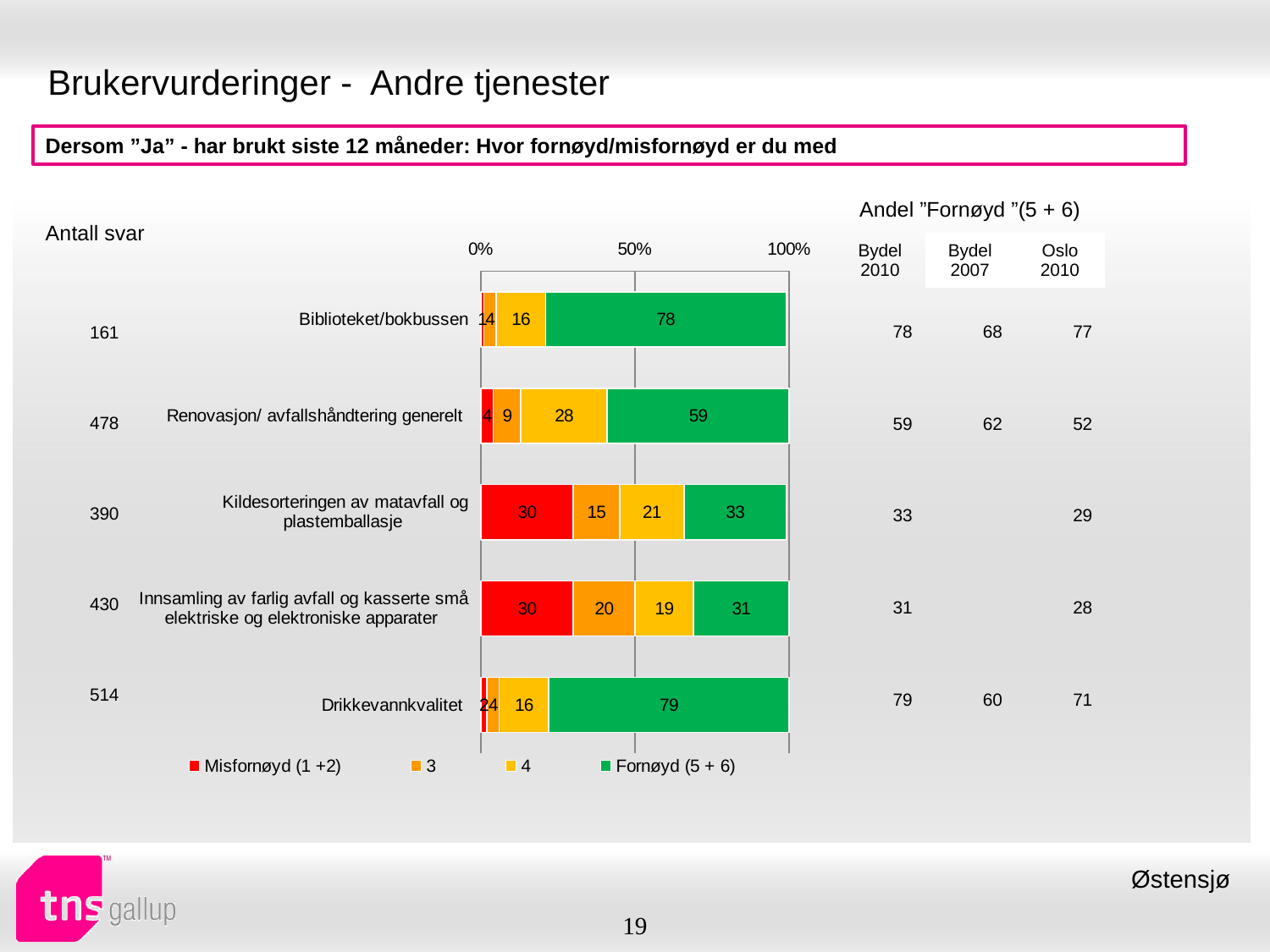
How many categories (services) are plotted in the chart? 5 What is the value of series 4 for Renovasjon/ avfallshåndtering generelt? 28 Which category has the lowest Fornøyd (5 + 6) value? Innsamling av farlig avfall og kasserte små elektriske og elektroniske apparater What is the Fornøyd (5 + 6) value for Drikkevannkvalitet? 79 Which category has the highest Fornøyd (5 + 6) value? Drikkevannkvalitet Which has the larger Fornøyd (5 + 6) value: Renovasjon/ avfallshåndtering generelt or Kildesorteringen av matavfall og plastemballasje? Renovasjon/ avfallshåndtering generelt What is the difference between the Fornøyd (5 + 6) values for Biblioteket/bokbussen and Kildesorteringen av matavfall og plastemballasje? 45 How many series does the chart legend list? 4 What is the value of series 3 for Innsamling av farlig avfall og kasserte små elektriske og elektroniske apparater? 20 What is the Misfornøyd (1 +2) value for Kildesorteringen av matavfall og plastemballasje? 30 What kind of chart is shown on the slide? bar chart What is the Fornøyd (5 + 6) value for Biblioteket/bokbussen? 78